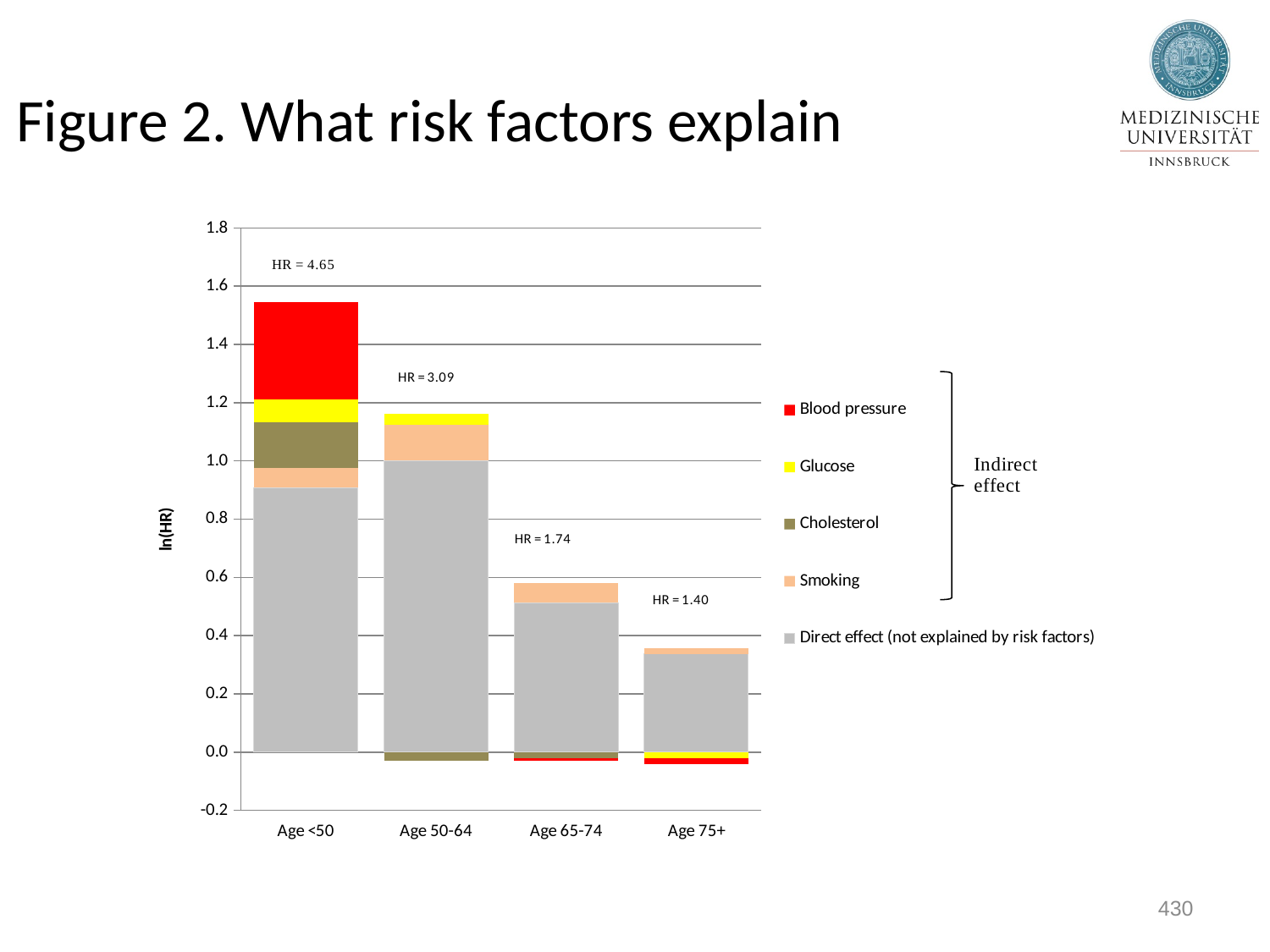
How many series does the legend list? 5 What HR value is printed above the bar for Age 75+? HR = 1.40 What HR value is printed above the bar for Age 65-74? HR = 1.74 Which age category has the tallest stacked bar? Age <50 Which age category has the shortest stacked bar? Age 75+ How many age categories are shown on the x axis? 4 What is the label on the y axis? ln(HR) Is the Direct effect value for Age 75+ greater or less than 0.4? less What HR value is printed above the bar for Age <50? HR = 4.65 What kind of chart is shown on the slide? Stacked bar chart Is the Direct effect value for Age <50 greater or less than 0.8? greater Do the bar heights rise or fall as age increases along the x axis? fall